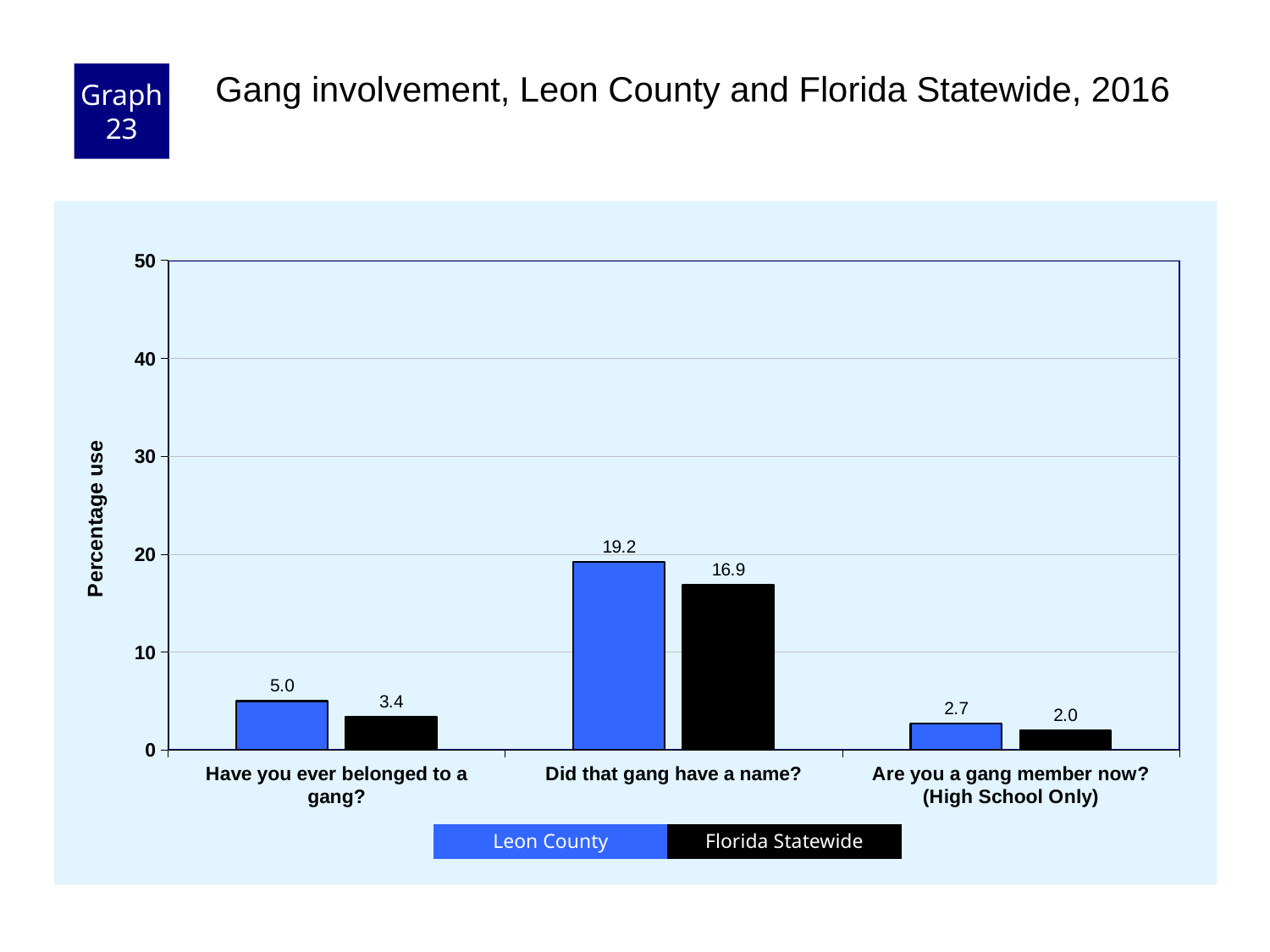
Which question has the highest Leon County value? Did that gang have a name? For "Have you ever belonged to a gang?", which is larger: Leon County or Florida Statewide? Leon County What is the Leon County value for "Have you ever belonged to a gang?"? 5.0 Which question has the lowest Florida Statewide value? Are you a gang member now? (High School Only) What is the Florida Statewide value for "Did that gang have a name?"? 16.9 What is the difference between the Leon County and Florida Statewide values for "Did that gang have a name?"? 2.3 What is the Florida Statewide value for "Have you ever belonged to a gang?"? 3.4 How many questions (categories) are shown on the x axis? 3 How many series does the legend list? 2 What kind of chart is shown on the slide? Bar chart Is the Leon County value for "Did that gang have a name?" greater or less than 10? greater What is the Leon County value for "Are you a gang member now? (High School Only)"? 2.7